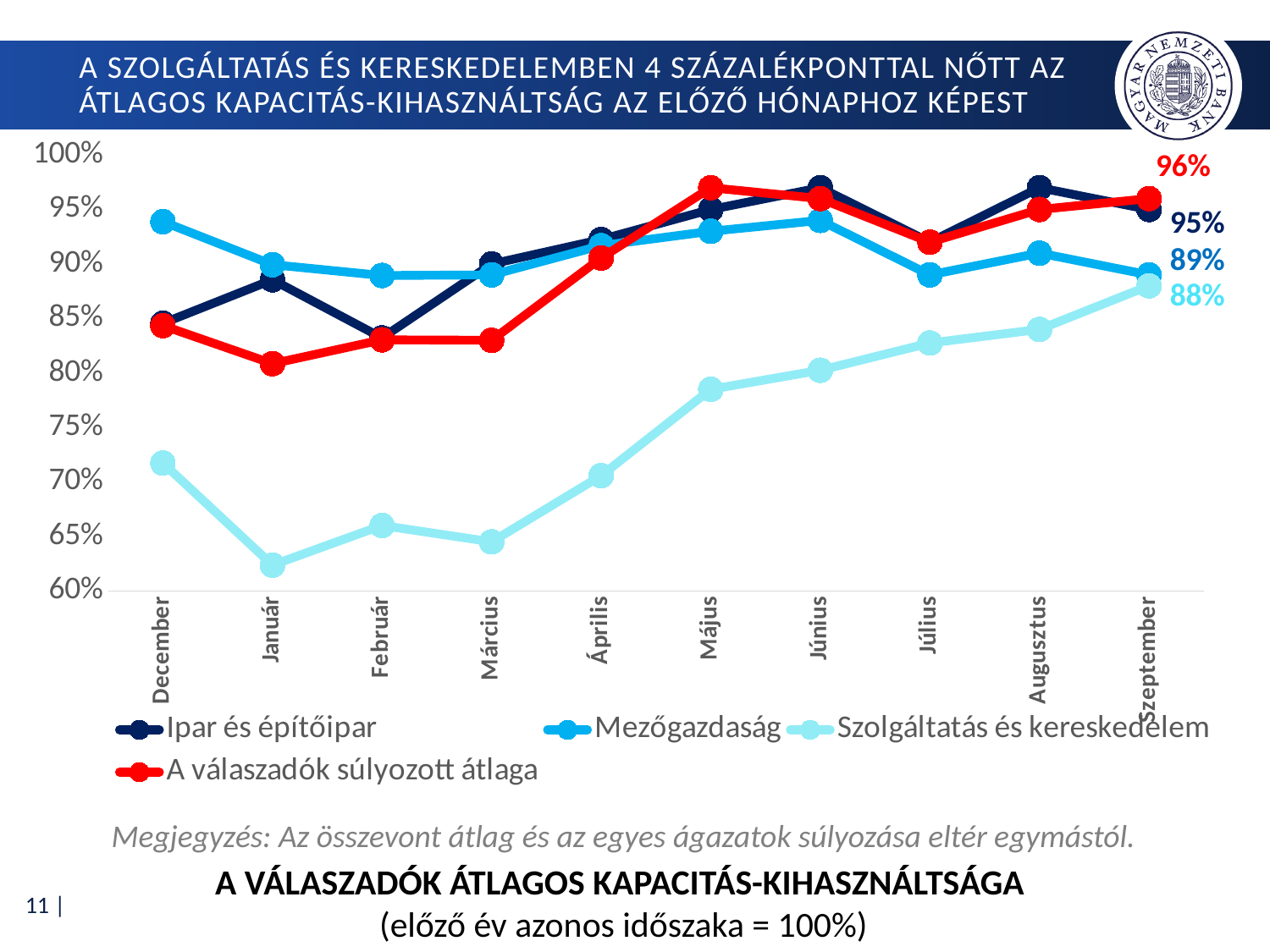
What is the value for A válaszadók súlyozott átlaga in Szeptember? 96% What is the value for Ipar és építőipar in Szeptember? 95% What is the value for Mezőgazdaság in Szeptember? 89% In Szeptember, which is higher: Ipar és építőipar or Mezőgazdaság? Ipar és építőipar How many months are shown on the x axis? 10 How many series does the legend list? 4 Is the value for Szolgáltatás és kereskedelem in Január greater or less than 65%? less Which series has the lowest value in December? Szolgáltatás és kereskedelem In Szeptember, how many percentage points higher is A válaszadók súlyozott átlaga than Szolgáltatás és kereskedelem? 8 percentage points Does the Szolgáltatás és kereskedelem line rise or fall from Március to Szeptember? rise What is the value for Szolgáltatás és kereskedelem in Szeptember? 88% What kind of chart is shown on the slide? line chart